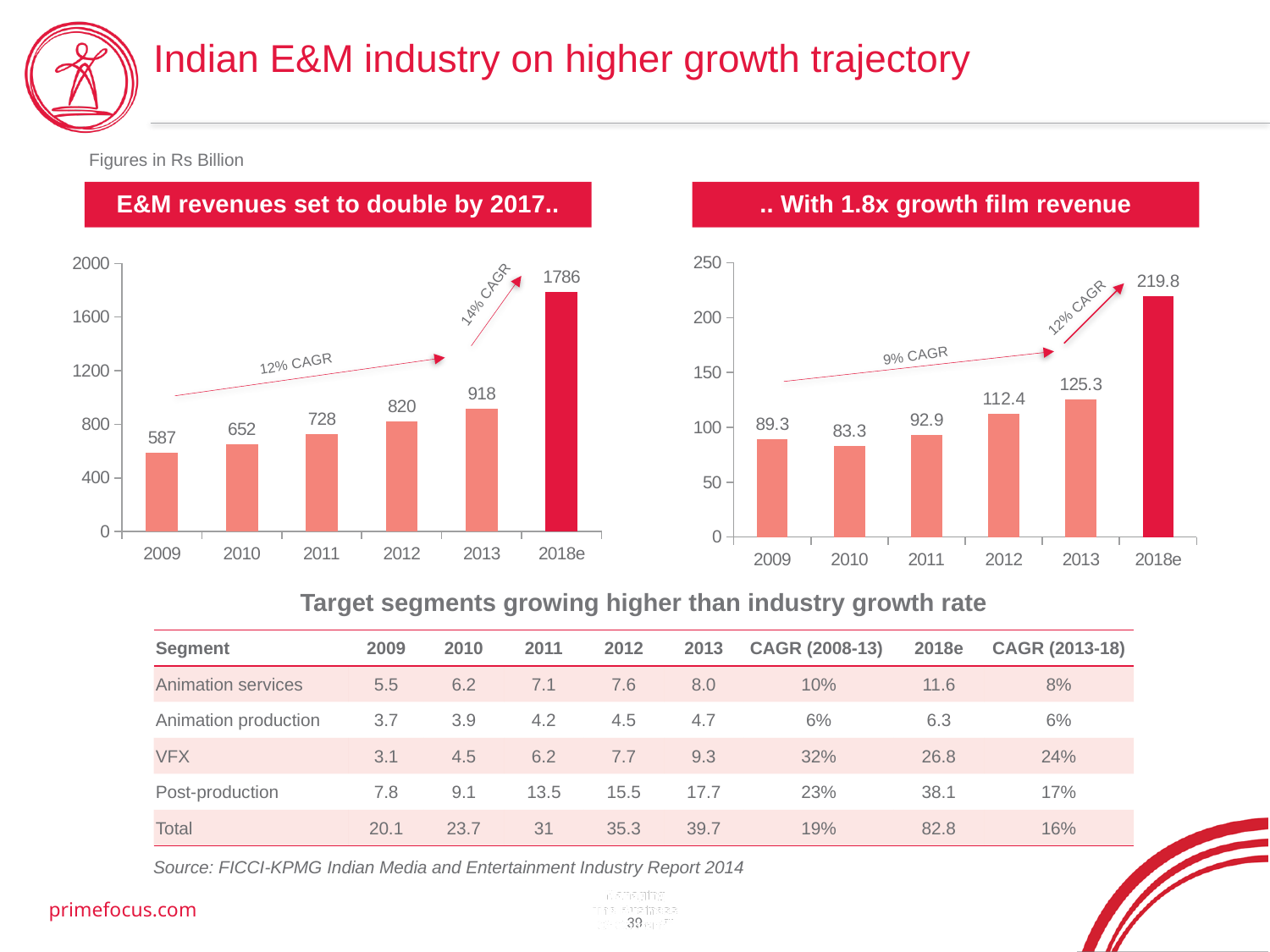
In the 'E&M revenues set to double by 2017..' chart, what is the value for 2018e? 1786 In the 'E&M revenues set to double by 2017..' chart, do the values rise or fall from 2009 to 2018e? Rise In the 'E&M revenues set to double by 2017..' chart, how many years are shown on the x axis? 6 In the '.. With 1.8x growth film revenue' chart, which is larger, the value for 2009 or the value for 2011? 2011 In the '.. With 1.8x growth film revenue' chart, what is the value for 2010? 83.3 In the 'E&M revenues set to double by 2017..' chart, what is the difference between the 2012 and 2011 values? 92 In the '.. With 1.8x growth film revenue' chart, which year has the lowest value? 2010 What type of chart is the '.. With 1.8x growth film revenue' chart? Bar chart In the '.. With 1.8x growth film revenue' chart, what is the difference between the 2018e and 2013 values? 94.5 In the '.. With 1.8x growth film revenue' chart, what CAGR is labelled on the arrow from 2013 to 2018e? 12% CAGR In the 'E&M revenues set to double by 2017..' chart, which year has the highest value? 2018e In the 'E&M revenues set to double by 2017..' chart, what is the value for 2013? 918